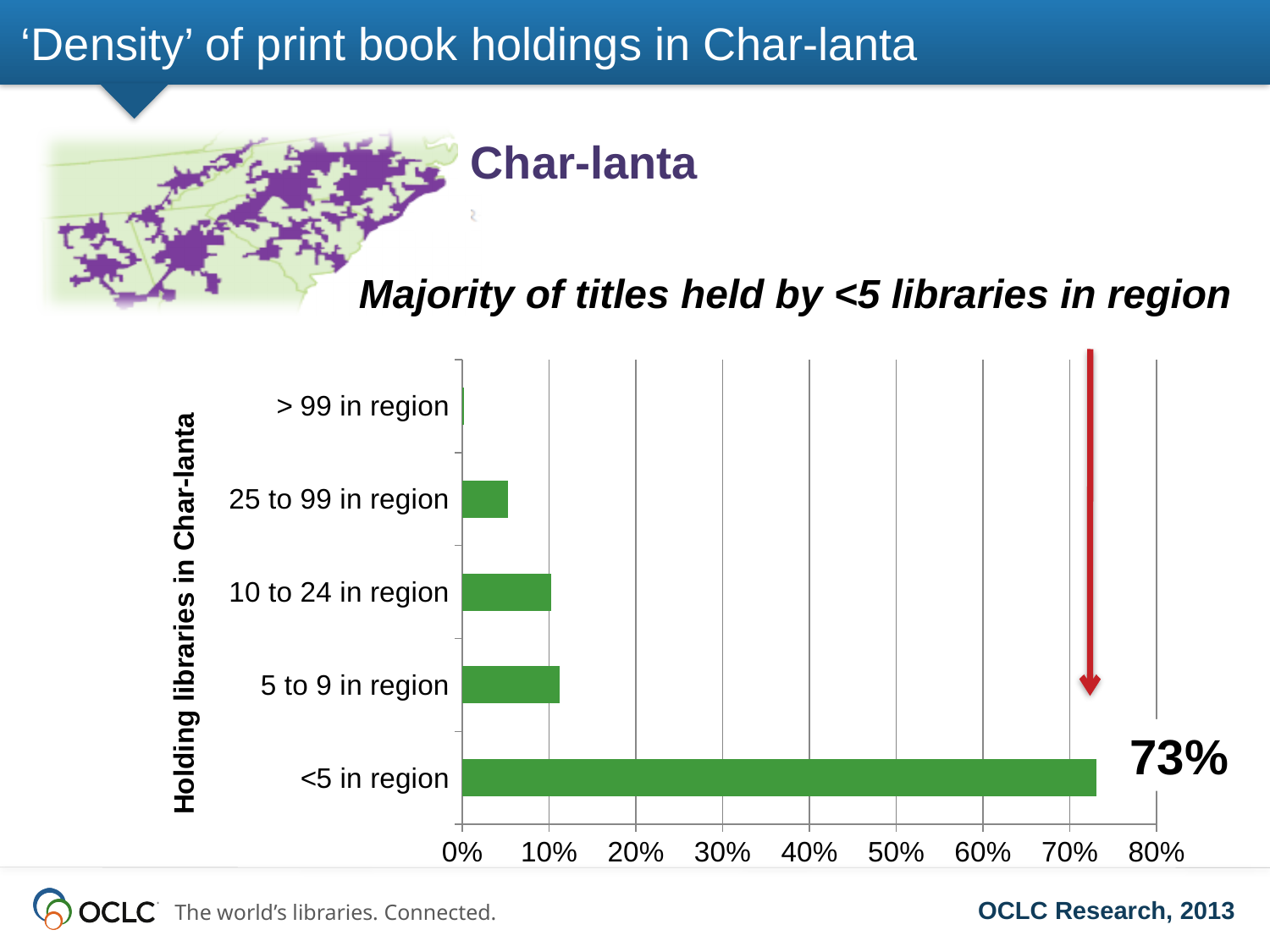
Is the value for "> 99 in region" greater or less than 10%? less What is the maximum value shown on the horizontal axis of the chart? 80% What is the title of the vertical axis of the chart? Holding libraries in Char-lanta How many categories are plotted on the chart? 5 Is the value for "25 to 99 in region" greater or less than 10%? less What is the value for the "<5 in region" category? 73% Which category has the lowest value? > 99 in region Is the value for "5 to 9 in region" greater or less than 20%? less Which category has the highest value? <5 in region Which is larger, the value for "5 to 9 in region" or the value for "25 to 99 in region"? 5 to 9 in region What type of chart is shown on the slide? bar chart